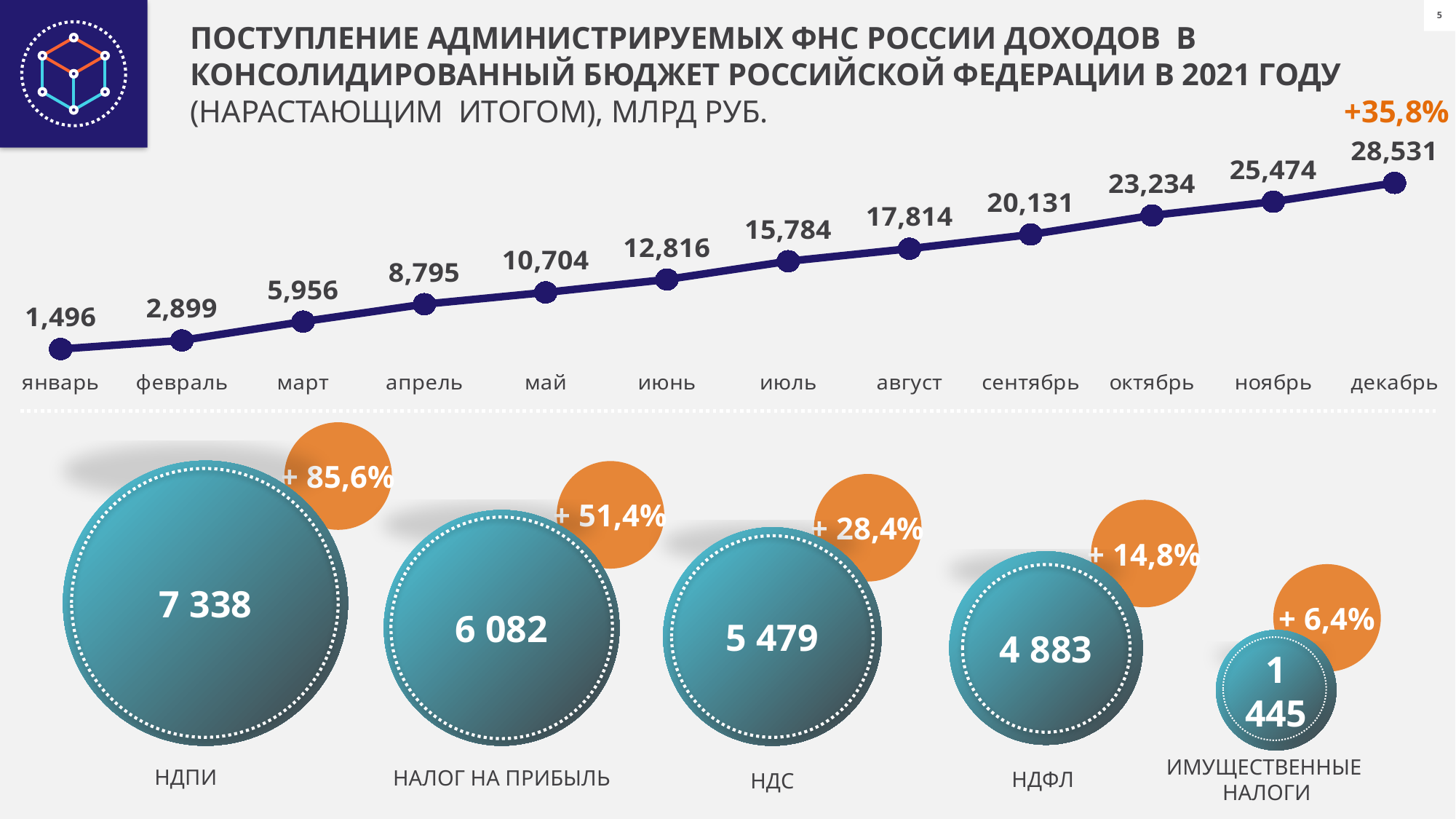
In the line chart at the top, which month has the lowest value? январь In the line chart at the top, what is the difference between the values for декабрь and ноябрь? 3,057 In the line chart at the top, what is the difference between the values for июнь and май? 2,112 In the line chart at the top, which is larger, the value for август or the value for июль? август In the line chart at the top, what is the value for май? 10,704 In the line chart at the top, which month has the highest value? декабрь In the line chart at the top, what is the value for декабрь? 28,531 In the circles at the bottom of the slide, what is the value shown for НДС? 5 479 In the line chart at the top, what is the value for январь? 1,496 In the line chart at the top, do the values rise or fall from январь to декабрь? rise What kind of chart is shown at the top of the slide? line chart In the line chart at the top, how many months are plotted? 12